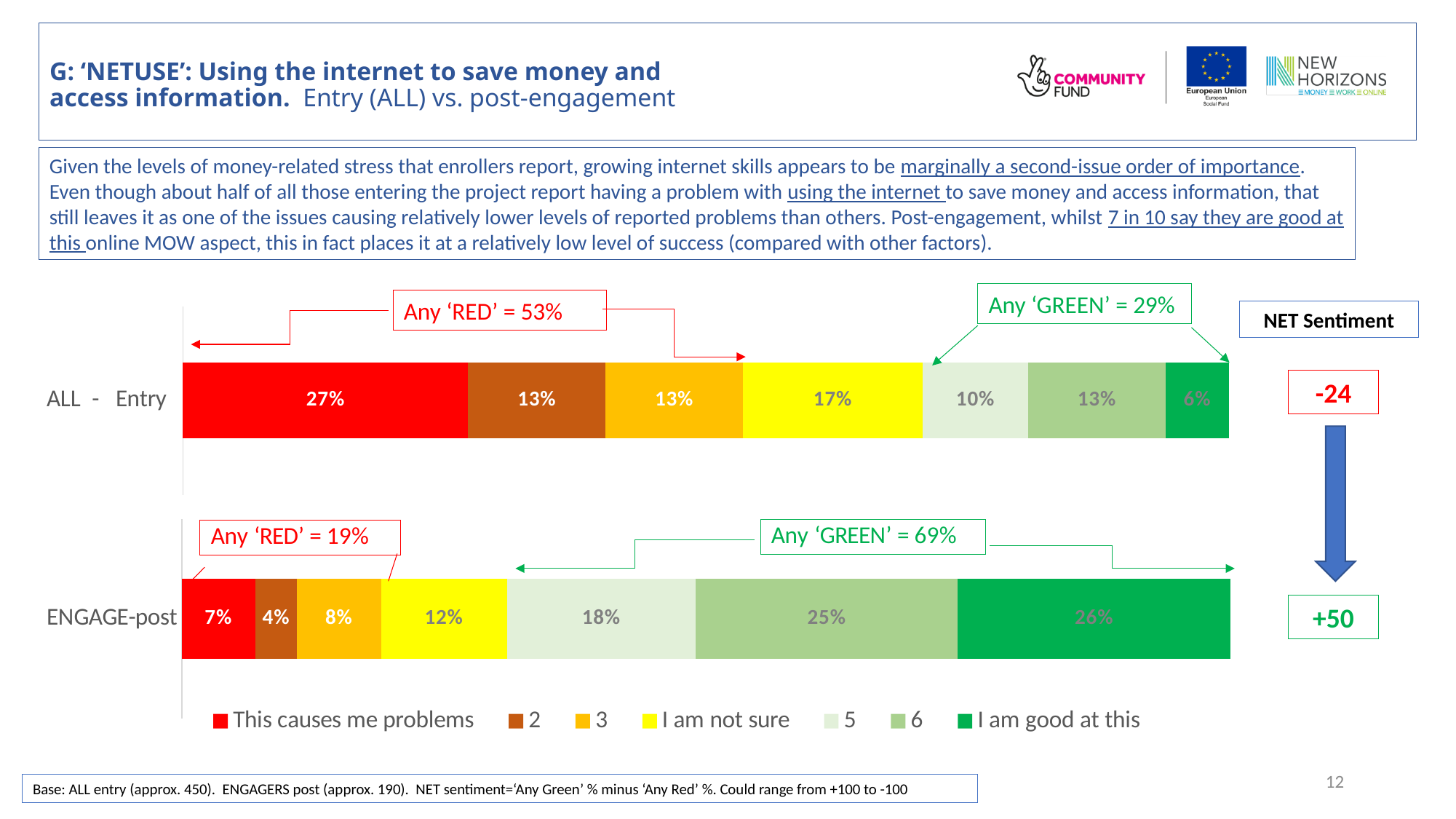
What is the value for 'I am not sure' in the ENGAGE-post bar? 12% Which bar has the larger 'This causes me problems' value, ALL - Entry or ENGAGE-post? ALL - Entry How many series does the legend list? 7 Which segment is the largest in the ALL - Entry bar? This causes me problems What is the difference between the 'I am good at this' values for ENGAGE-post and ALL - Entry? 20% What percentage of the ENGAGE-post bar is 'I am good at this'? 26% Which segment is the smallest in the ENGAGE-post bar? 2 What is the value for series 6 in the ALL - Entry bar? 13% How many categories (bars) are plotted in the chart? 2 What is the NET Sentiment value shown for ENGAGE-post? +50 What percentage of the ALL - Entry bar is 'This causes me problems'? 27% What kind of chart is shown on the slide? Stacked bar chart